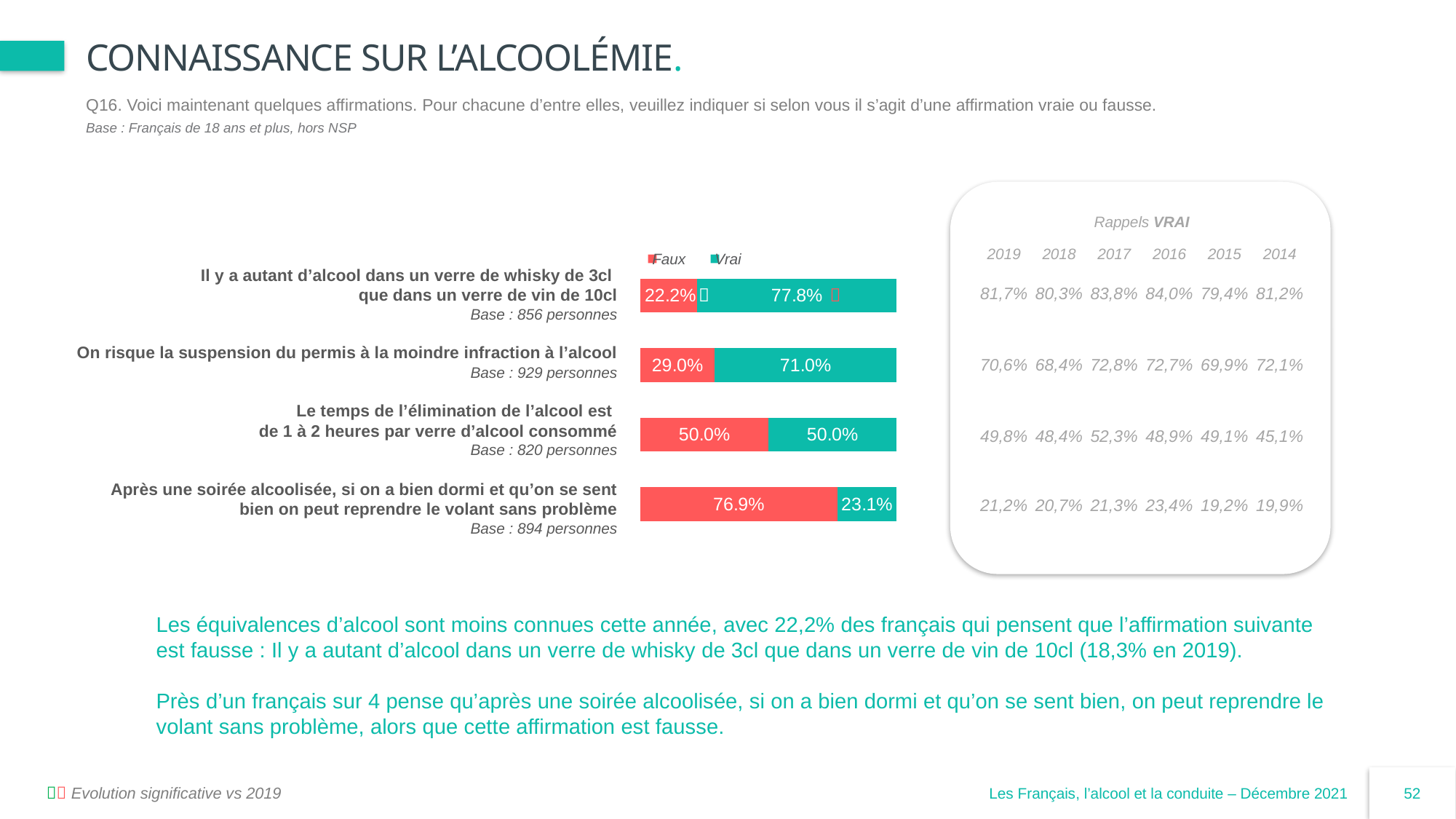
What type of chart is used to show the Faux/Vrai responses? Stacked bar chart Which statement has the highest "Faux" share? Après une soirée alcoolisée, si on a bien dormi et qu'on se sent bien on peut reprendre le volant sans problème Which colour represents the "Faux" series in the chart? Red What is the difference between the "Vrai" and "Faux" shares for the statement "On risque la suspension du permis à la moindre infraction à l'alcool"? 42.0 percentage points What is the "Faux" value for the statement "Le temps de l'élimination de l'alcool est de 1 à 2 heures par verre d'alcool consommé"? 50.0% What percentage of respondents answered "Faux" for the statement "On risque la suspension du permis à la moindre infraction à l'alcool"? 29.0% How many series does the chart legend list? 2 Which statement has the lowest "Vrai" share? Après une soirée alcoolisée, si on a bien dormi et qu'on se sent bien on peut reprendre le volant sans problème What is the "Vrai" value for the statement "Après une soirée alcoolisée, si on a bien dormi et qu'on se sent bien on peut reprendre le volant sans problème"? 23.1% How many statements are shown in the bar chart? 4 What percentage of respondents answered "Vrai" for the statement "Il y a autant d'alcool dans un verre de whisky de 3cl que dans un verre de vin de 10cl"? 77.8% For the whisky/wine statement, which is larger: the "Faux" share or the "Vrai" share? Vrai